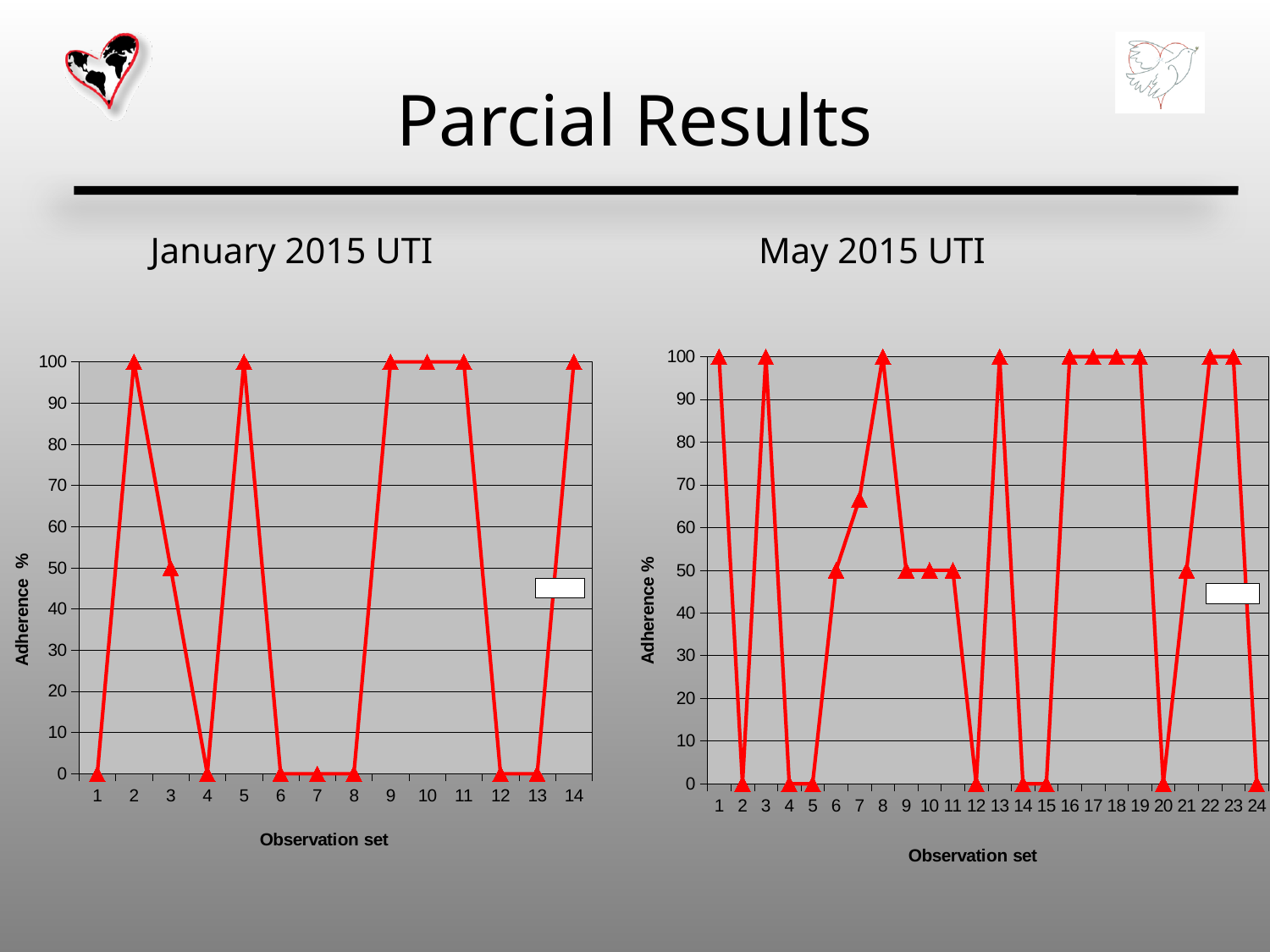
On the May 2015 UTI chart, what is the adherence % for observation set 20? 0 On the January 2015 UTI chart, which is larger, the adherence % for observation set 2 or observation set 3? Observation set 2 What is the label on the y axis of the May 2015 UTI chart? Adherence % What type of chart is the January 2015 UTI chart? Line chart On the January 2015 UTI chart, what is the adherence % for observation set 12? 0 On the May 2015 UTI chart, what is the difference in adherence % between observation set 8 and observation set 9? 50 On the January 2015 UTI chart, what is the adherence % for observation set 3? 50 How many observation sets are plotted on the January 2015 UTI chart? 14 On the May 2015 UTI chart, what is the adherence % for observation set 6? 50 How many observation sets are plotted on the May 2015 UTI chart? 24 On the January 2015 UTI chart, what is the adherence % for observation set 9? 100 On the May 2015 UTI chart, is the adherence % for observation set 7 greater or less than 60? greater